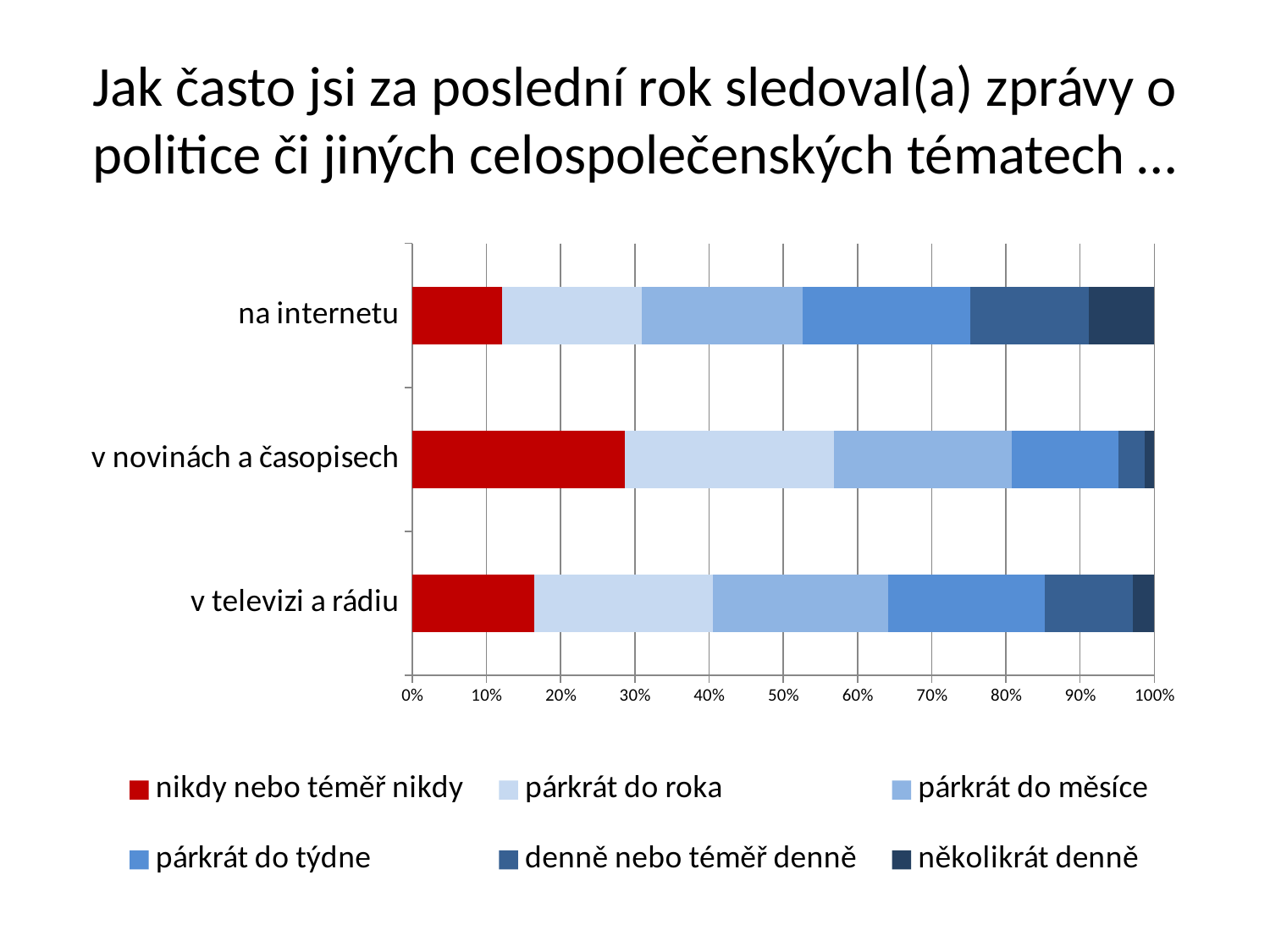
Is the "nikdy nebo téměř nikdy" share for "na internetu" greater or less than 20%? less Which category has the largest share of "nikdy nebo téměř nikdy"? v novinách a časopisech Which has a larger "denně nebo téměř denně" share: "na internetu" or "v novinách a časopisech"? na internetu Which category has the smallest share of "nikdy nebo téměř nikdy"? na internetu How many categories (media types) are shown on the y axis of the chart? 3 Which has a larger "párkrát do týdne" share: "na internetu" or "v novinách a časopisech"? na internetu Which category has the largest share of "několikrát denně"? na internetu Is the "nikdy nebo téměř nikdy" share for "v televizi a rádiu" greater or less than 10%? greater What kind of chart is shown on the slide? stacked bar chart Which colour represents the "nikdy nebo téměř nikdy" series in the chart? red How many series does the chart's legend list? 6 Is the "nikdy nebo téměř nikdy" share for "v novinách a časopisech" greater or less than 20%? greater